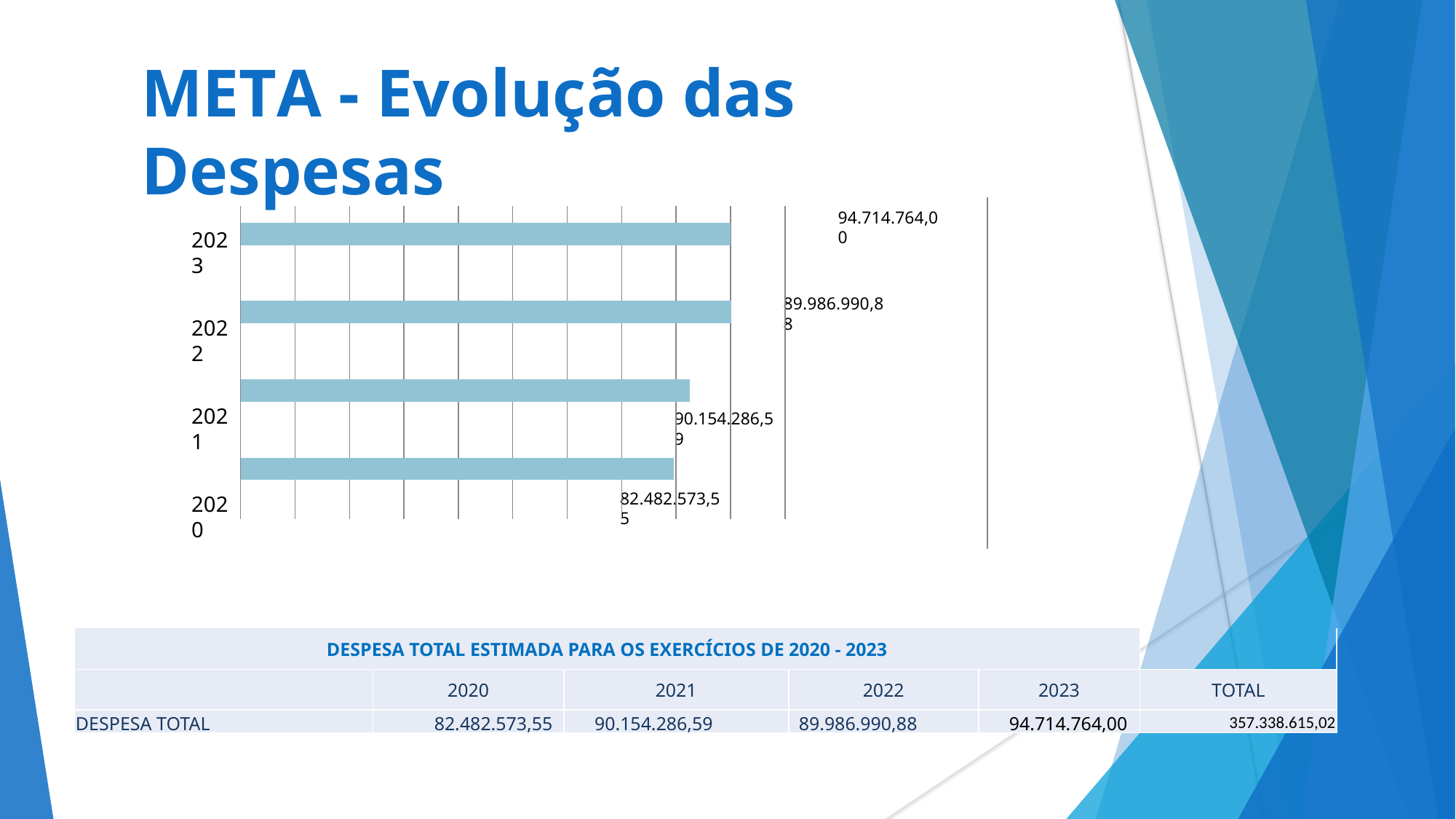
What is the value shown for 2023 in the bar chart? 94.714.764,00 What is the value shown for 2020 in the bar chart? 82.482.573,55 What is the value shown for 2021 in the bar chart? 90.154.286,59 Which year has the highest value in the bar chart? 2023 What is the difference between the values for 2021 and 2020 in the bar chart? 7.671.713,04 What kind of chart is shown on the slide? Bar chart How many years are shown in the bar chart? 4 Which is larger in the bar chart, the value for 2023 or the value for 2020? 2023 What is the title of the slide containing the chart? META - Evolução das Despesas What is the value shown for 2022 in the bar chart? 89.986.990,88 What is the difference between the values for 2023 and 2020 in the bar chart? 12.232.190,45 Which year has the lowest value in the bar chart? 2020